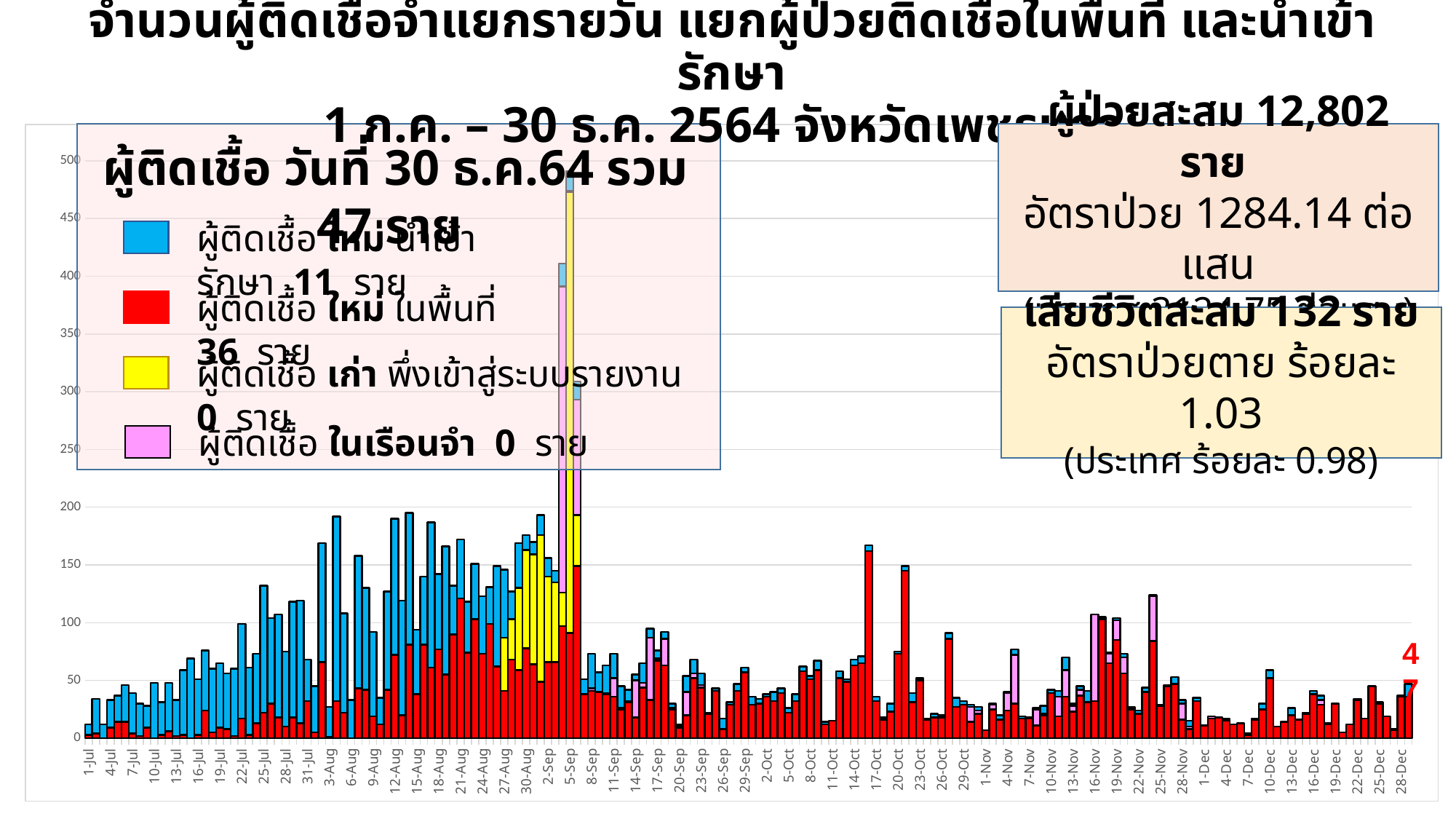
Do the bar values generally rise or fall from 5-Sep to 28-Sep? fall Which colour represents ผู้ติดเชื้อ ใหม่ นำเข้ารักษา (new imported cases) in the legend? blue What kind of chart is shown on the slide? bar chart What is the highest value shown on the chart's vertical axis? 500 Is the total value for 1-Jul greater or less than 50? less How many series does the chart's legend list? 4 Is the total value for 28-Dec greater or less than 100? less Is the total value for 3-Aug greater or less than 150? less Which is larger, the total value for 1-Jul or the total value for 12-Aug? 12-Aug Which is larger, the total value for 3-Aug or the total value for 4-Dec? 3-Aug